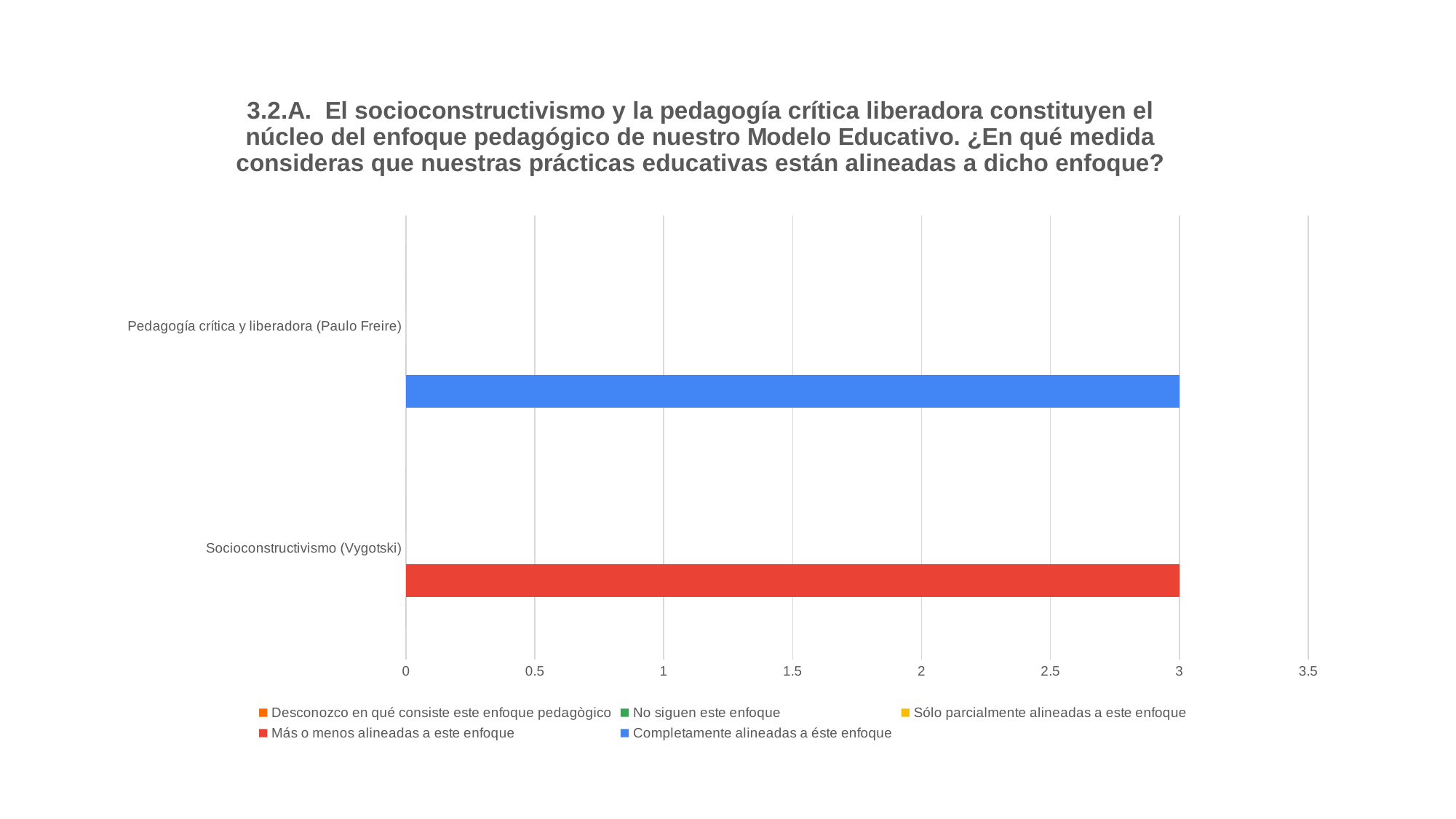
What is the value of the 'Completamente alineadas a éste enfoque' bar for 'Pedagogía crítica y liberadora (Paulo Freire)'? 3 What is the value of the 'Más o menos alineadas a este enfoque' bar for 'Socioconstructivismo (Vygotski)'? 3 How many series does the legend list? 5 How many categories are shown on the vertical axis of the chart? 2 What is the highest value shown on the horizontal axis of the chart? 3.5 Which legend series has a visible bar for 'Socioconstructivismo (Vygotski)'? Más o menos alineadas a este enfoque Which legend series has a visible bar for 'Pedagogía crítica y liberadora (Paulo Freire)'? Completamente alineadas a éste enfoque What is the difference between the blue bar for 'Pedagogía crítica y liberadora (Paulo Freire)' and the red bar for 'Socioconstructivismo (Vygotski)'? 0 What kind of chart is shown on the slide? bar chart Is the value of the red bar for 'Socioconstructivismo (Vygotski)' greater or less than 3.5? less Is the value of the blue bar for 'Pedagogía crítica y liberadora (Paulo Freire)' greater or less than 2? greater